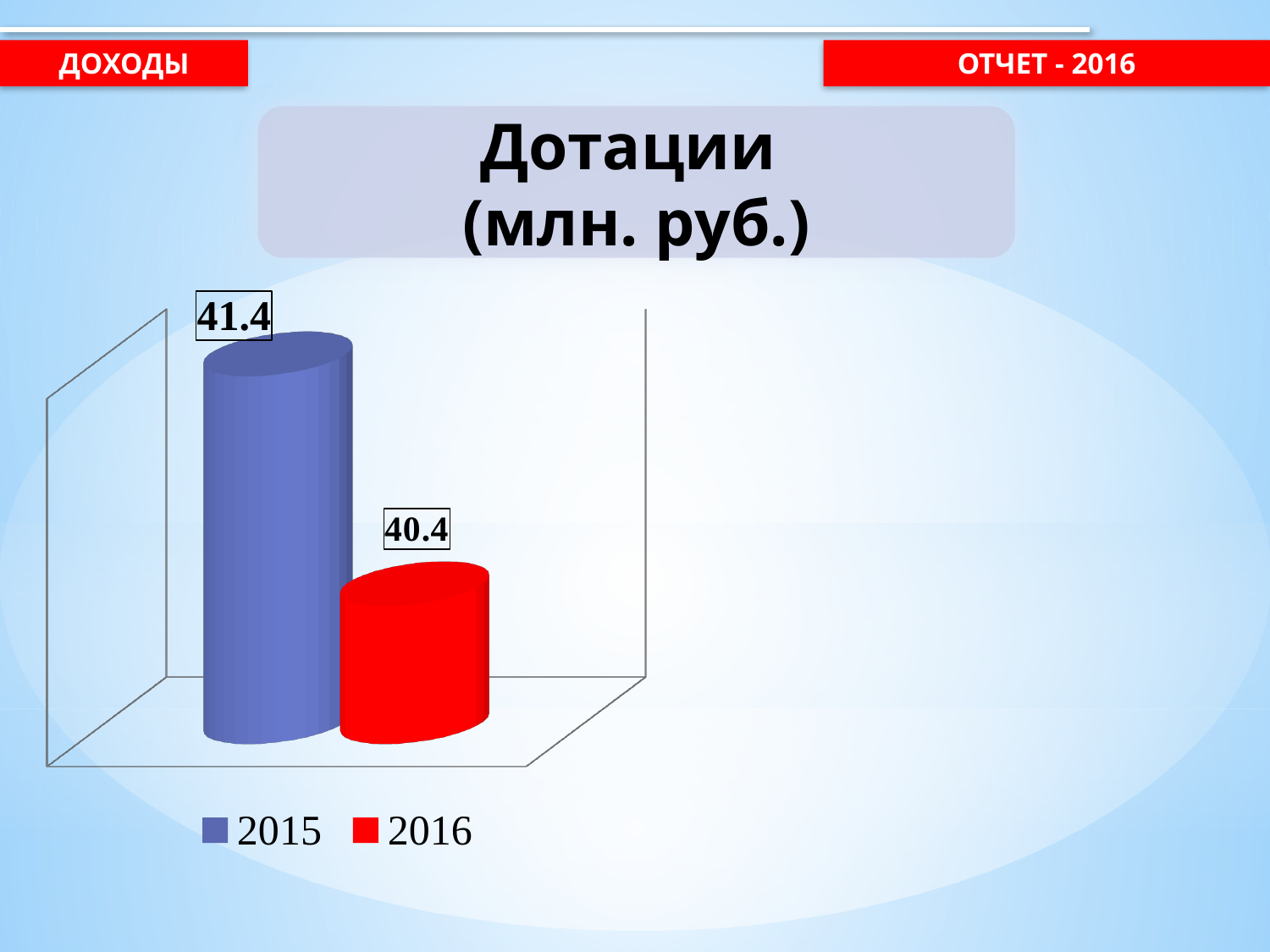
How many series does the legend list? 2 What is the title of the chart? Дотации (млн. руб.) What colour is the bar for 2016? red What is the value for 2016? 40.4 What kind of chart is shown on the slide? bar chart What is the difference between the 2015 and 2016 values? 1.0 Which year has the higher value, 2015 or 2016? 2015 What is the value for 2015? 41.4 Which series has the highest value? 2015 How many bars are plotted on the chart? 2 Do the values rise or fall from 2015 to 2016? fall Which series has the lowest value? 2016